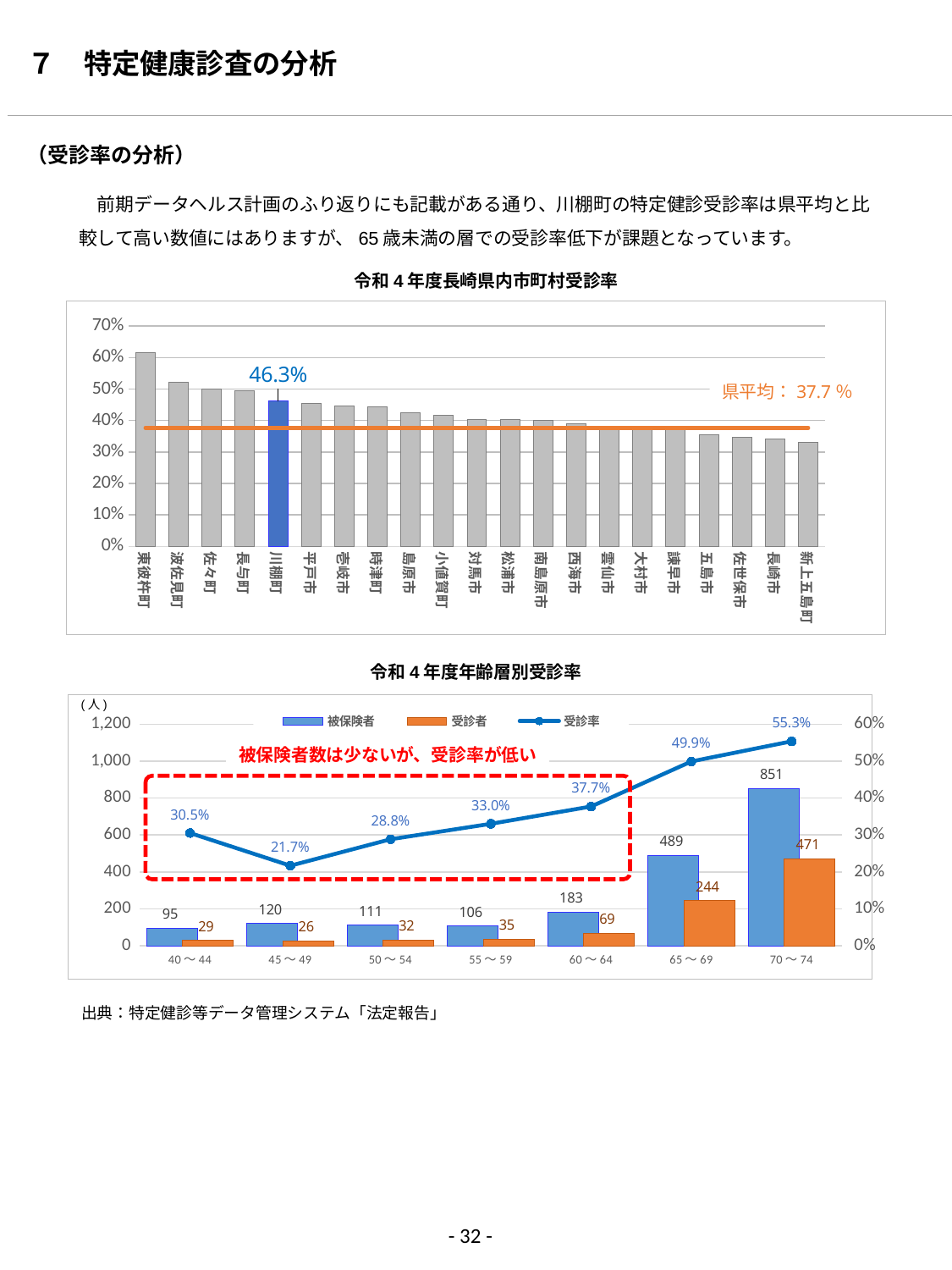
In the chart titled 令和4年度年齢層別受診率, what is the difference between 被保険者 and 受診者 for the 65～69 age group? 245 In the chart titled 令和4年度年齢層別受診率, which age group has the highest 受診率? 70～74 In the chart titled 令和4年度年齢層別受診率, what is the 被保険者 value for the 70～74 age group? 851 In the chart titled 令和4年度長崎県内市町村受診率, which municipality has the highest bar? 東彼杵町 In the chart titled 令和4年度長崎県内市町村受診率, how many municipalities are shown on the x axis? 21 In the chart titled 令和4年度長崎県内市町村受診率, what is the value printed for 川棚町? 46.3% In the chart titled 令和4年度年齢層別受診率, how many series does the legend list? 3 In the chart titled 令和4年度長崎県内市町村受診率, what is the 県平均 value shown? 37.7% In the chart titled 令和4年度長崎県内市町村受診率, which municipality has the lowest bar? 新上五島町 In the chart titled 令和4年度年齢層別受診率, which is larger, the 受診者 value for 60～64 or for 55～59? 60～64 In the chart titled 令和4年度長崎県内市町村受診率, is the value for 東彼杵町 greater or less than 60%? greater In the chart titled 令和4年度年齢層別受診率, what is the 受診率 for the 45～49 age group? 21.7%